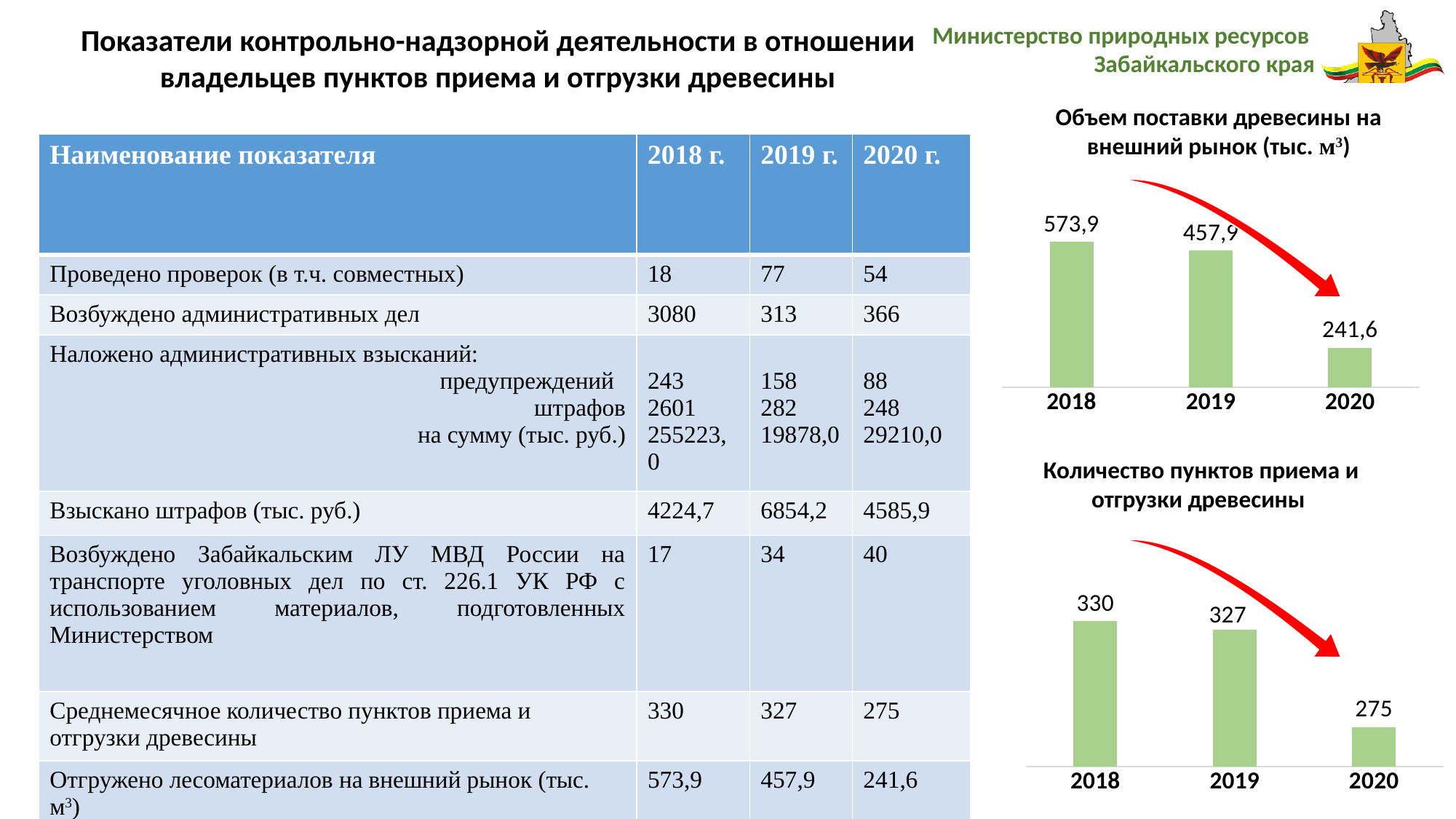
In the chart 'Количество пунктов приема и отгрузки древесины', what is the value for 2020? 275 In the chart 'Объем поставки древесины на внешний рынок (тыс. м³)', how many years are plotted? 3 In the chart 'Объем поставки древесины на внешний рынок (тыс. м³)', do the values rise or fall from 2018 to 2020? fall In the chart 'Объем поставки древесины на внешний рынок (тыс. м³)', which year has the lowest value? 2020 In the chart 'Количество пунктов приема и отгрузки древесины', what is the value for 2019? 327 In the chart 'Объем поставки древесины на внешний рынок (тыс. м³)', what is the value for 2020? 241,6 In the chart 'Количество пунктов приема и отгрузки древесины', which is larger, the value for 2018 or the value for 2020? 2018 In the chart 'Количество пунктов приема и отгрузки древесины', what is the difference between the 2019 and 2020 values? 52 What type of chart is the bottom-right chart 'Количество пунктов приема и отгрузки древесины'? bar chart In the chart 'Объем поставки древесины на внешний рынок (тыс. м³)', what is the difference between the 2018 and 2019 values? 116,0 In the chart 'Количество пунктов приема и отгрузки древесины', which year has the highest value? 2018 In the chart 'Объем поставки древесины на внешний рынок (тыс. м³)', what is the value for 2018? 573,9